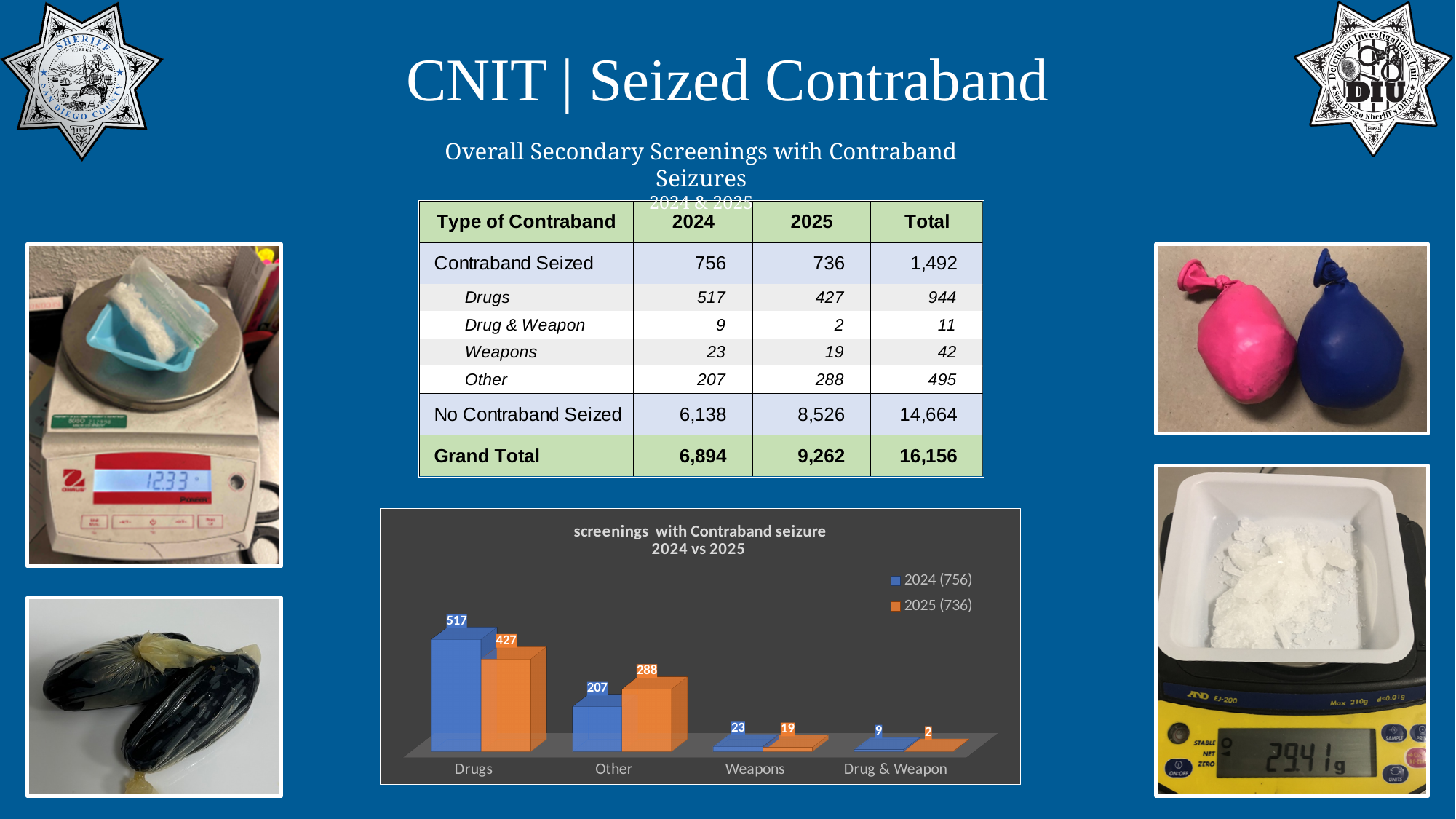
What kind of chart is shown on the slide? Bar chart What is the 2025 value for Weapons in the chart? 19 Which category has the highest 2024 value in the chart? Drugs Which category has the lowest 2025 value in the chart? Drug & Weapon What is the 2025 value for Other in the chart? 288 Which is larger for Other in the chart, the 2024 value or the 2025 value? 2025 How many series does the chart legend list? 2 What are the two legend entries in the chart? 2024 (756) and 2025 (736) How many categories are shown on the x axis of the chart? 4 What is the 2024 value for Drugs in the chart? 517 What is the title of the chart? screenings with Contraband seizure 2024 vs 2025 What is the difference between the 2024 and 2025 values for Drugs in the chart? 90